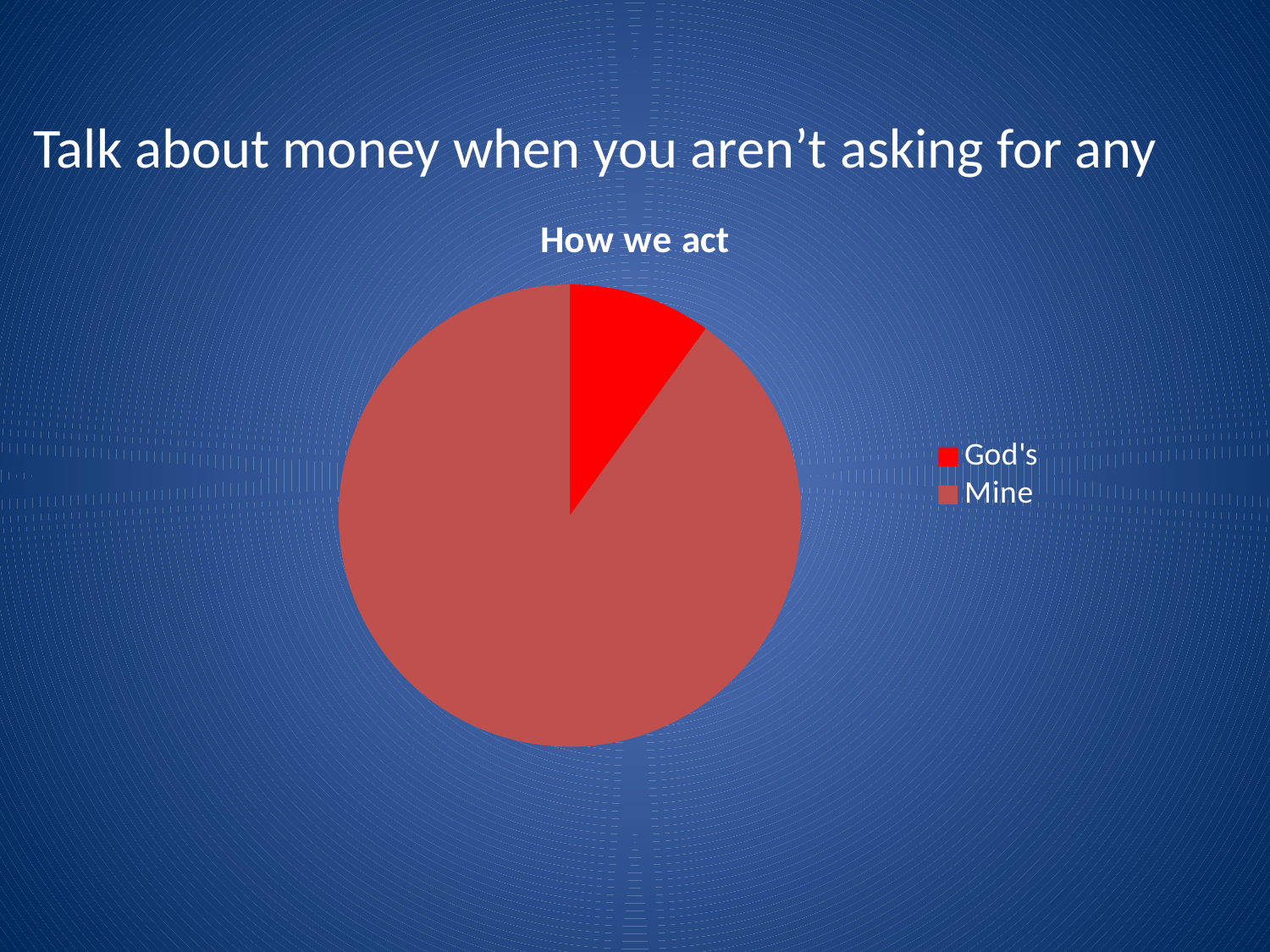
Which slice is the largest in the pie chart? Mine What is the title of the chart? How we act How many slices does the pie chart have? 2 Does the God's slice take up more or less than half of the pie? less What colour is the God's slice in the pie chart? bright red What kind of chart is shown on the slide? pie chart Which is larger, the God's slice or the Mine slice? Mine Which slice is the smallest in the pie chart? God's How many entries does the legend list? 2 Does the Mine slice take up more or less than half of the pie? more